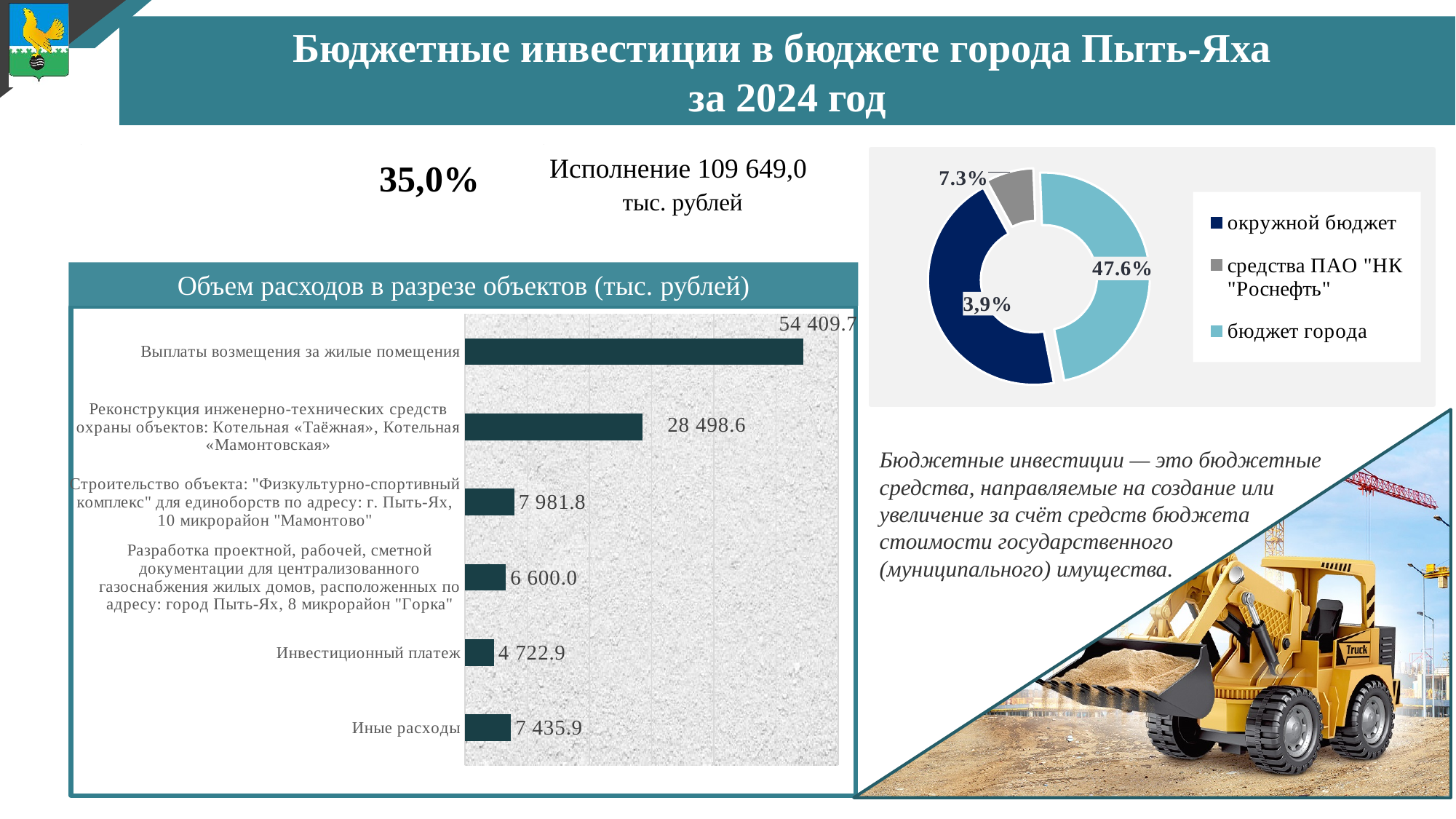
On the bar chart 'Объем расходов в разрезе объектов (тыс. рублей)', what is the value for 'Иные расходы'? 7 435.9 What kind of chart is 'Объем расходов в разрезе объектов (тыс. рублей)'? Bar chart How many categories are shown on the bar chart 'Объем расходов в разрезе объектов (тыс. рублей)'? 6 How many entries does the legend of the doughnut chart at the top right list? 3 On the bar chart 'Объем расходов в разрезе объектов (тыс. рублей)', what is the difference between 'Выплаты возмещения за жилые помещения' and 'Реконструкция инженерно-технических средств охраны объектов: Котельная «Таёжная», Котельная «Мамонтовская»'? 25 911.1 On the bar chart 'Объем расходов в разрезе объектов (тыс. рублей)', which category has the lowest value? Инвестиционный платеж On the bar chart 'Объем расходов в разрезе объектов (тыс. рублей)', what is the value for 'Выплаты возмещения за жилые помещения'? 54 409.7 On the bar chart 'Объем расходов в разрезе объектов (тыс. рублей)', which is larger: 'Иные расходы' or 'Инвестиционный платеж'? Иные расходы On the bar chart 'Объем расходов в разрезе объектов (тыс. рублей)', which category has the highest value? Выплаты возмещения за жилые помещения On the bar chart 'Объем расходов в разрезе объектов (тыс. рублей)', what is the value for 'Инвестиционный платеж'? 4 722.9 On the doughnut chart at the top right, what share is labelled for 'бюджет города'? 47.6% On the doughnut chart at the top right, which legend entry has the smallest slice? средства ПАО "НК "Роснефть"